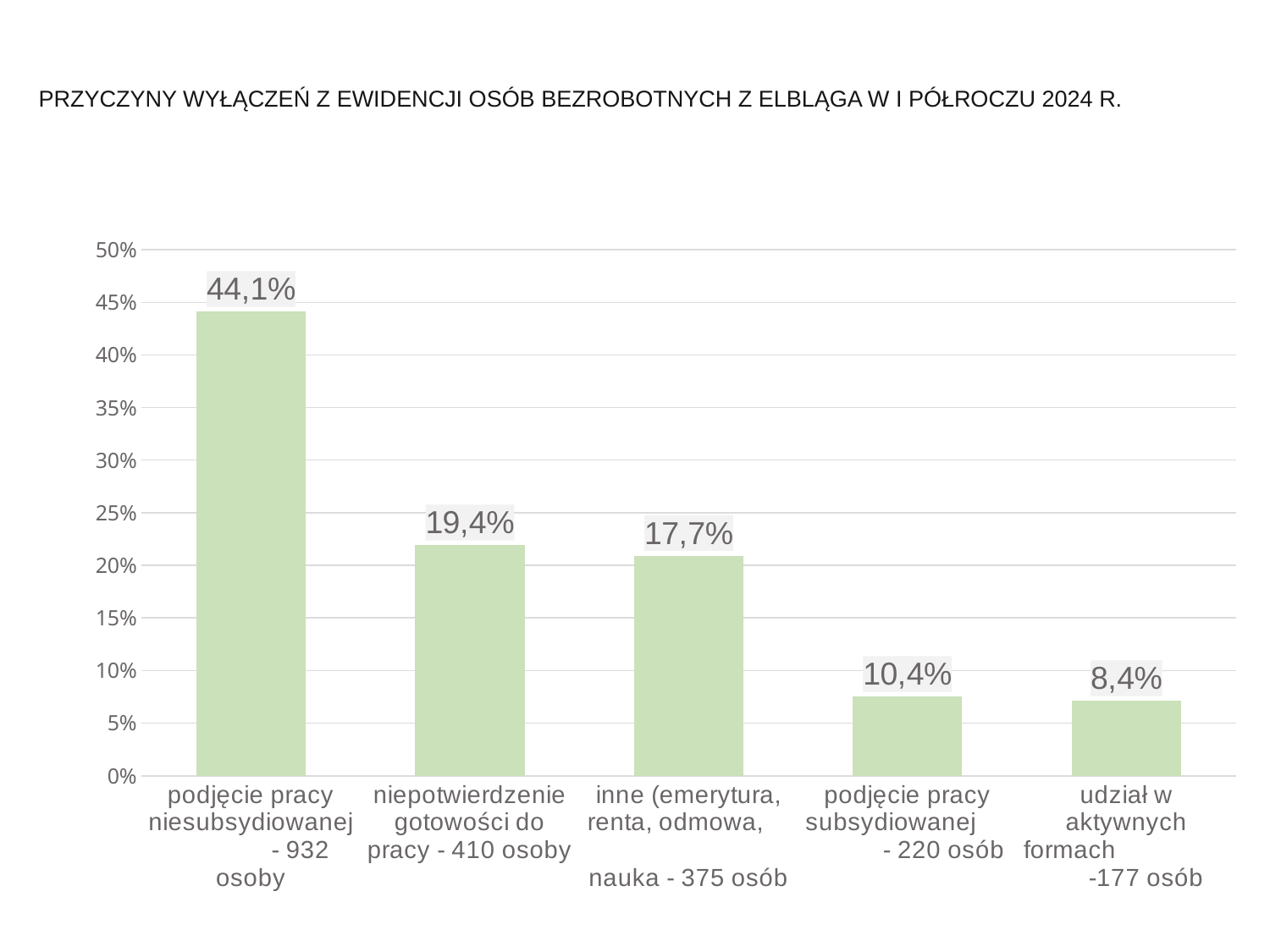
What is the value for 'inne (emerytura, renta, odmowa, nauka)'? 17,7% How many categories are shown on the x axis? 5 Which category has the lowest value? udział w aktywnych formach What is the value for 'podjęcie pracy niesubsydiowanej'? 44,1% Which is larger: the value for 'inne (emerytura, renta, odmowa, nauka)' or for 'podjęcie pracy subsydiowanej'? inne (emerytura, renta, odmowa, nauka) What is the value for 'udział w aktywnych formach'? 8,4% What kind of chart is shown on the slide? bar chart Do the values rise or fall from left to right along the x axis? fall What is the difference between the values for 'podjęcie pracy niesubsydiowanej' and 'niepotwierdzenie gotowości do pracy'? 24,7 percentage points What is the value for 'niepotwierdzenie gotowości do pracy'? 19,4% What is the title of the chart? PRZYCZYNY WYŁĄCZEŃ Z EWIDENCJI OSÓB BEZROBOTNYCH Z ELBLĄGA W I PÓŁROCZU 2024 R. Which category has the highest value? podjęcie pracy niesubsydiowanej